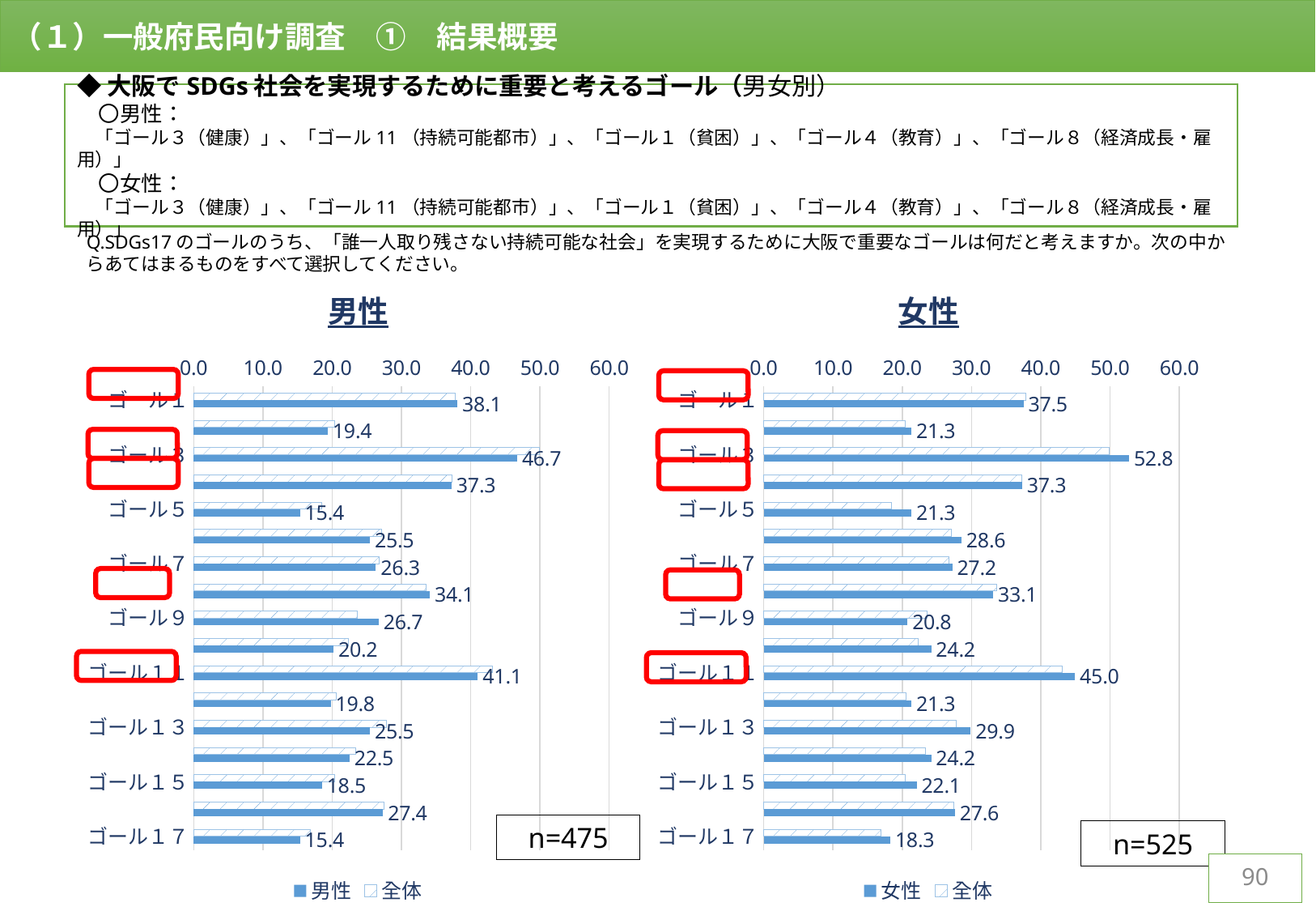
In the 女性 chart, which is larger in the 女性 series: ゴール1 or ゴール13? ゴール1 In the 女性 chart, which goal has the lowest value in the 女性 series? ゴール17 In the 男性 chart, what is the difference between the 男性 values for ゴール3 and ゴール11? 5.6 What kind of chart is the 女性 chart? bar chart What sample size (n) is shown for the 女性 chart? n=525 How many goals (categories) are plotted in the 女性 chart? 17 In the 女性 chart, which goal has the highest value in the 女性 series? ゴール3 In the 男性 chart, what is the value for ゴール3 in the 男性 series? 46.7 In the 女性 chart, what is the value for ゴール11 in the 女性 series? 45.0 In the 男性 chart, which goal has the highest value in the 男性 series? ゴール3 How many series does the legend of the 男性 chart list? 2 In the 男性 chart, is the 男性 value for ゴール11 greater or less than 40.0? greater